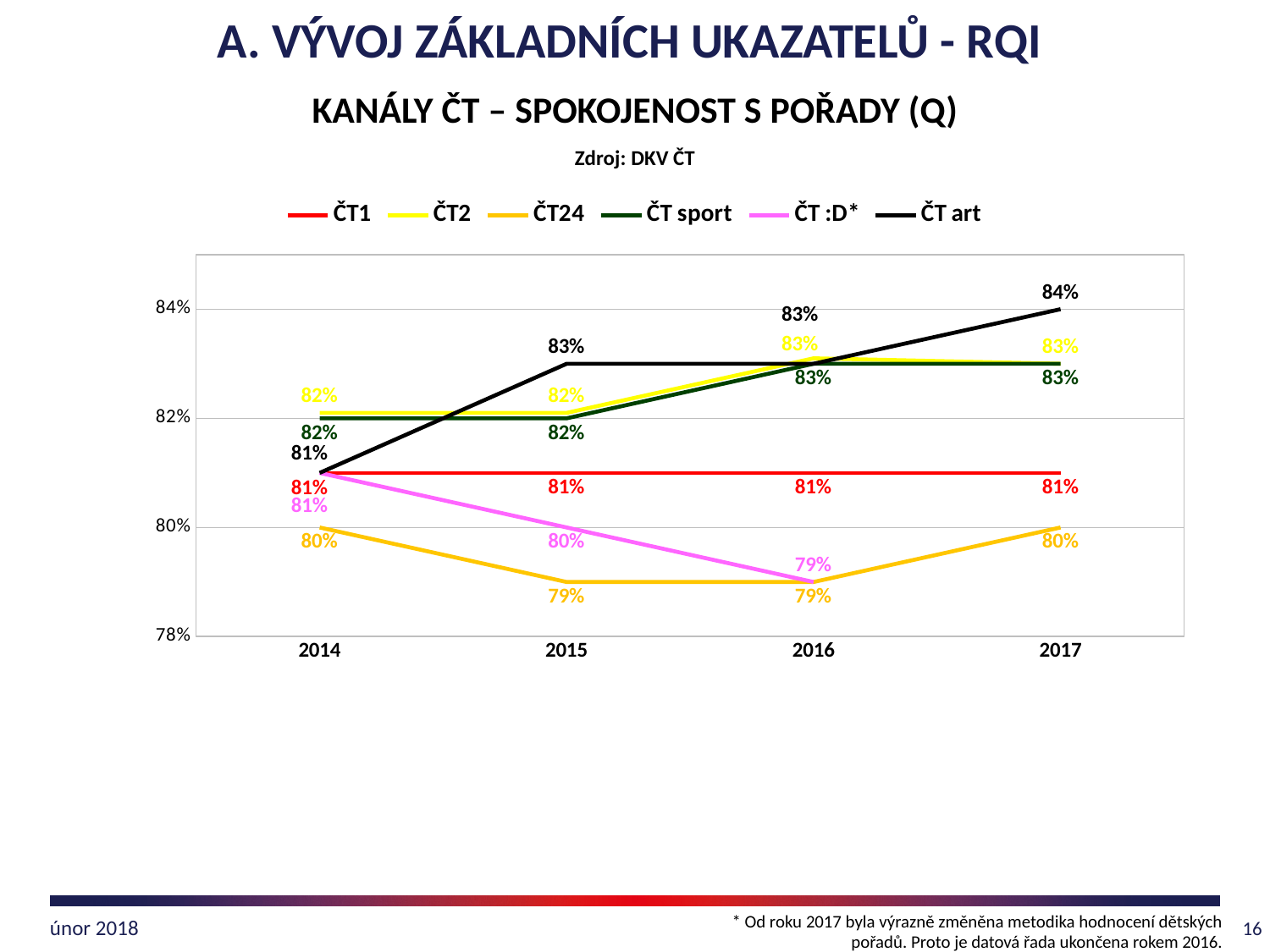
How many years are shown on the x axis? 4 Which is larger in 2016, the value for ČT1 or the value for ČT24? ČT1 What is the value for ČT :D* in 2016? 79% What kind of chart is shown on the slide? line chart Which series has the lowest value in 2015? ČT24 What is the value for ČT24 in 2015? 79% What is the value for ČT1 in 2014? 81% How many series does the legend list? 6 Does the value for ČT :D* rise or fall from 2014 to 2016? fall What is the difference between the ČT art value in 2017 and the ČT art value in 2014? 3% What is the value for ČT art in 2017? 84% Which series has the highest value in 2017? ČT art